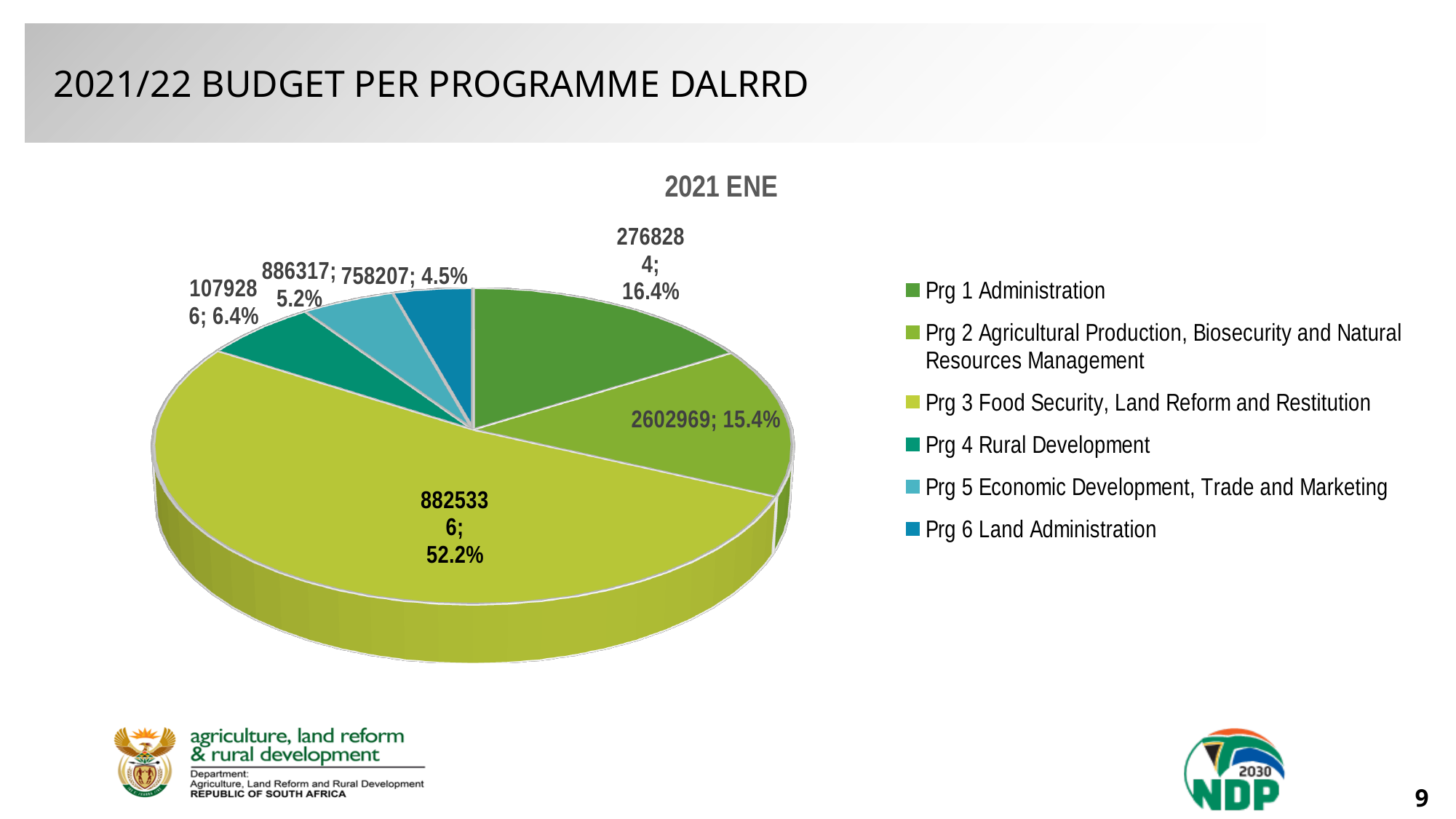
Which has the larger share: Prg 4 Rural Development or Prg 5 Economic Development, Trade and Marketing? Prg 4 Rural Development How many programmes does the legend list? 6 What share of the pie does Prg 3 Food Security, Land Reform and Restitution represent? 52.2% What is the value shown for Prg 5 Economic Development, Trade and Marketing? 886317 What is the title of the chart? 2021 ENE What is the value shown for Prg 6 Land Administration? 758207 What type of chart is shown on the slide? pie chart Which programme has the smallest slice of the pie? Prg 6 Land Administration What is the difference in percentage share between Prg 1 Administration and Prg 2 Agricultural Production, Biosecurity and Natural Resources Management? 1.0% Which programme has the largest slice of the pie? Prg 3 Food Security, Land Reform and Restitution What is the value shown for Prg 2 Agricultural Production, Biosecurity and Natural Resources Management? 2602969 What share of the pie does Prg 1 Administration represent? 16.4%